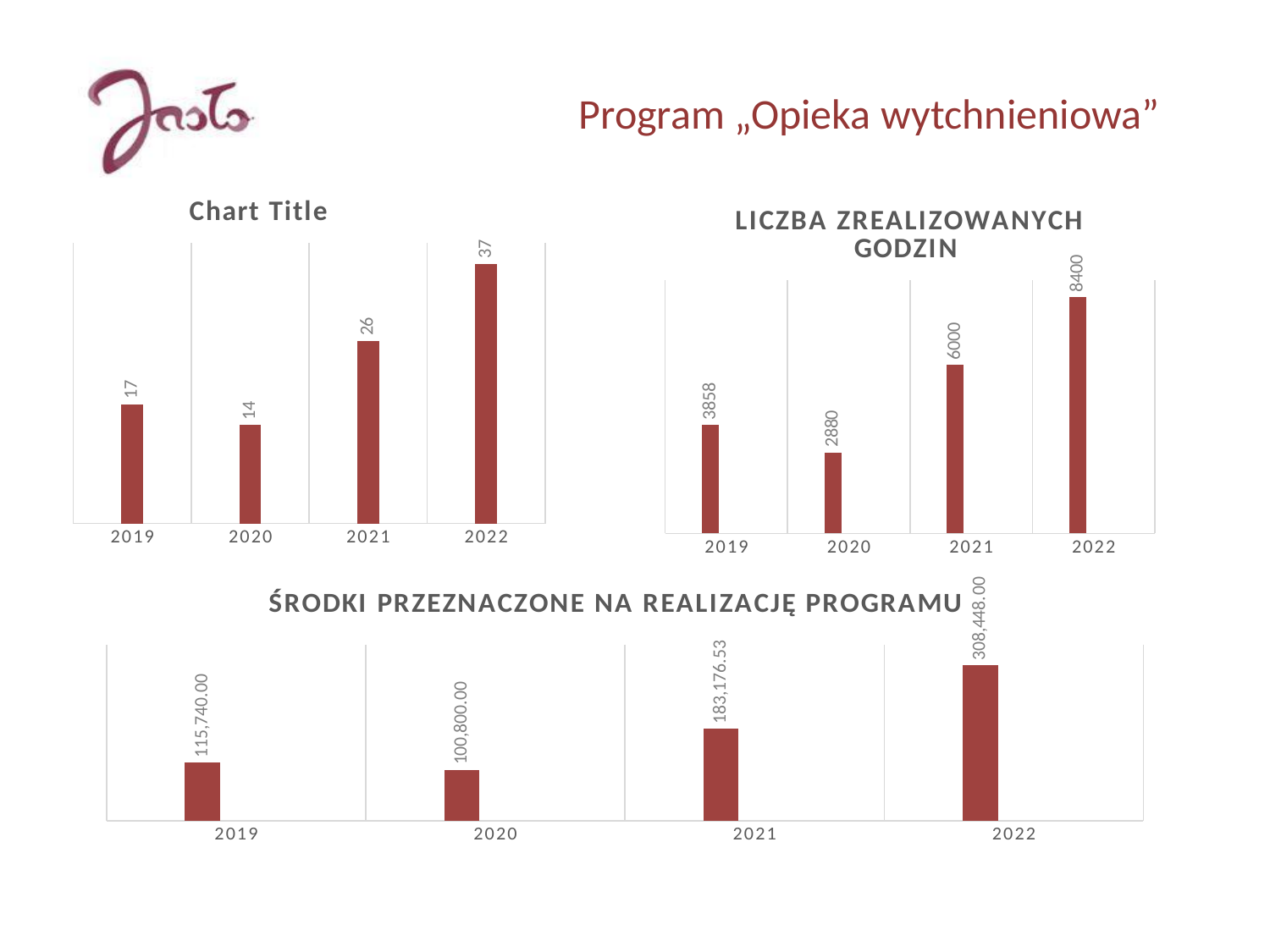
In the "ŚRODKI PRZEZNACZONE NA REALIZACJĘ PROGRAMU" chart, what is the value for 2022? 308,448.00 What kind of chart is the "LICZBA ZREALIZOWANYCH GODZIN" chart? Bar chart In the "ŚRODKI PRZEZNACZONE NA REALIZACJĘ PROGRAMU" chart, what is the value for 2021? 183,176.53 In the top-left chart titled "Chart Title", what is the difference between the values for 2022 and 2019? 20 In the "ŚRODKI PRZEZNACZONE NA REALIZACJĘ PROGRAMU" chart, which year has the lowest value? 2020 In the "LICZBA ZREALIZOWANYCH GODZIN" chart, what is the value for 2020? 2880 In the "LICZBA ZREALIZOWANYCH GODZIN" chart, what is the difference between the values for 2022 and 2021? 2400 In the "LICZBA ZREALIZOWANYCH GODZIN" chart, which year has the highest value? 2022 In the top-left chart titled "Chart Title", what is the value for 2021? 26 In the "LICZBA ZREALIZOWANYCH GODZIN" chart, which is larger, the value for 2019 or the value for 2020? 2019 How many years are shown on the x axis of the "ŚRODKI PRZEZNACZONE NA REALIZACJĘ PROGRAMU" chart? 4 In the top-left chart titled "Chart Title", which year has the lowest value? 2020